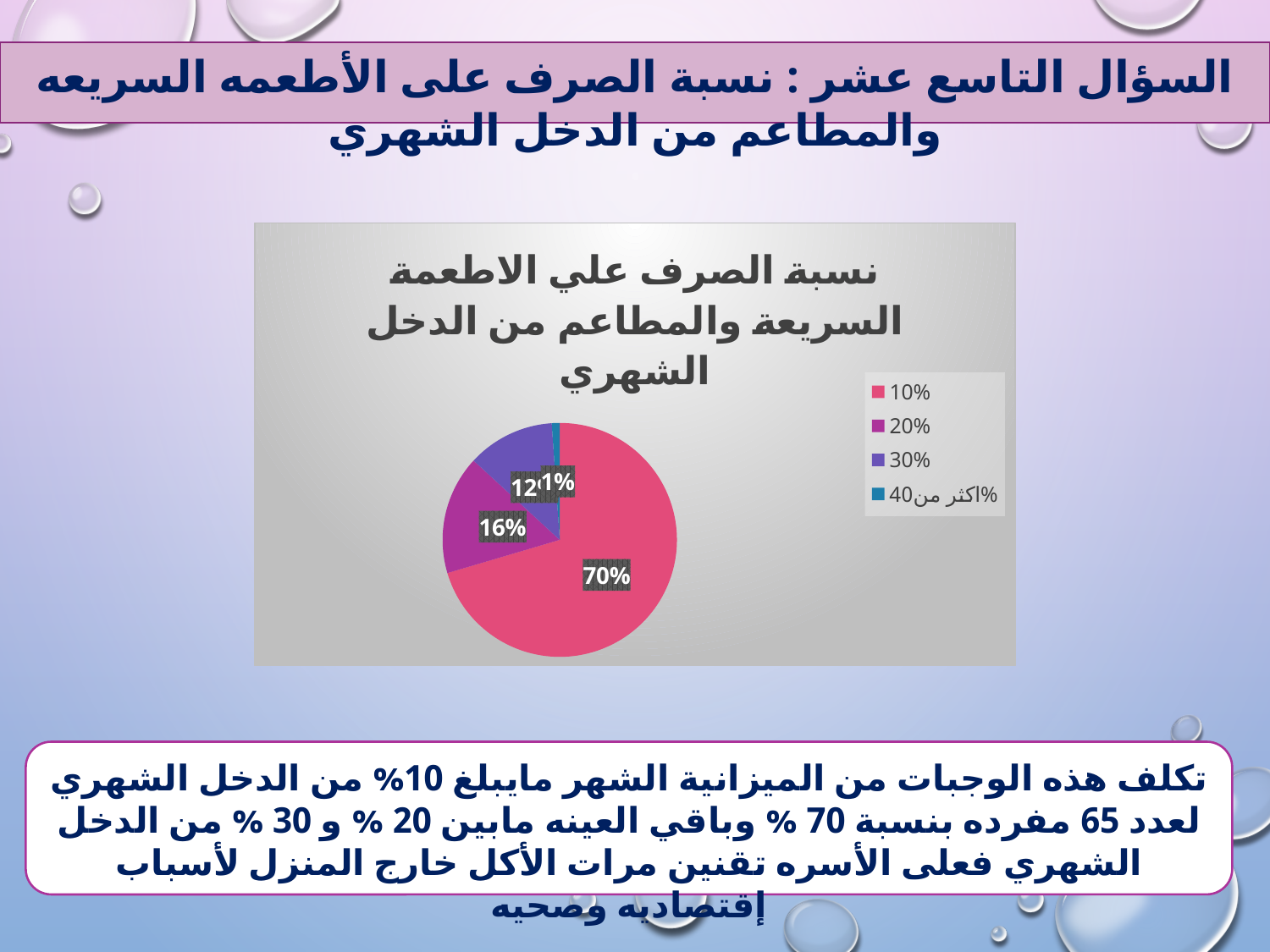
What is the title of the chart? نسبة الصرف علي الاطعمة السريعة والمطاعم من الدخل الشهري What colour is the slice for the "10%" category? Pink/red What share of the pie does the "10%" category have? 70% Which category has the smallest slice of the pie? اكثر من 40% What is the difference between the share of the "10%" category and the share of the "20%" category? 54 percentage points Which category has the largest slice of the pie? 10% Which slice is larger, the one for "20%" or the one for "30%"? 20% What type of chart is shown on the slide? Pie chart What share of the pie does the "اكثر من 40%" category have? 1% What share of the pie does the "20%" category have? 16% How many entries does the legend list? 4 How many slices does the pie chart have? 4